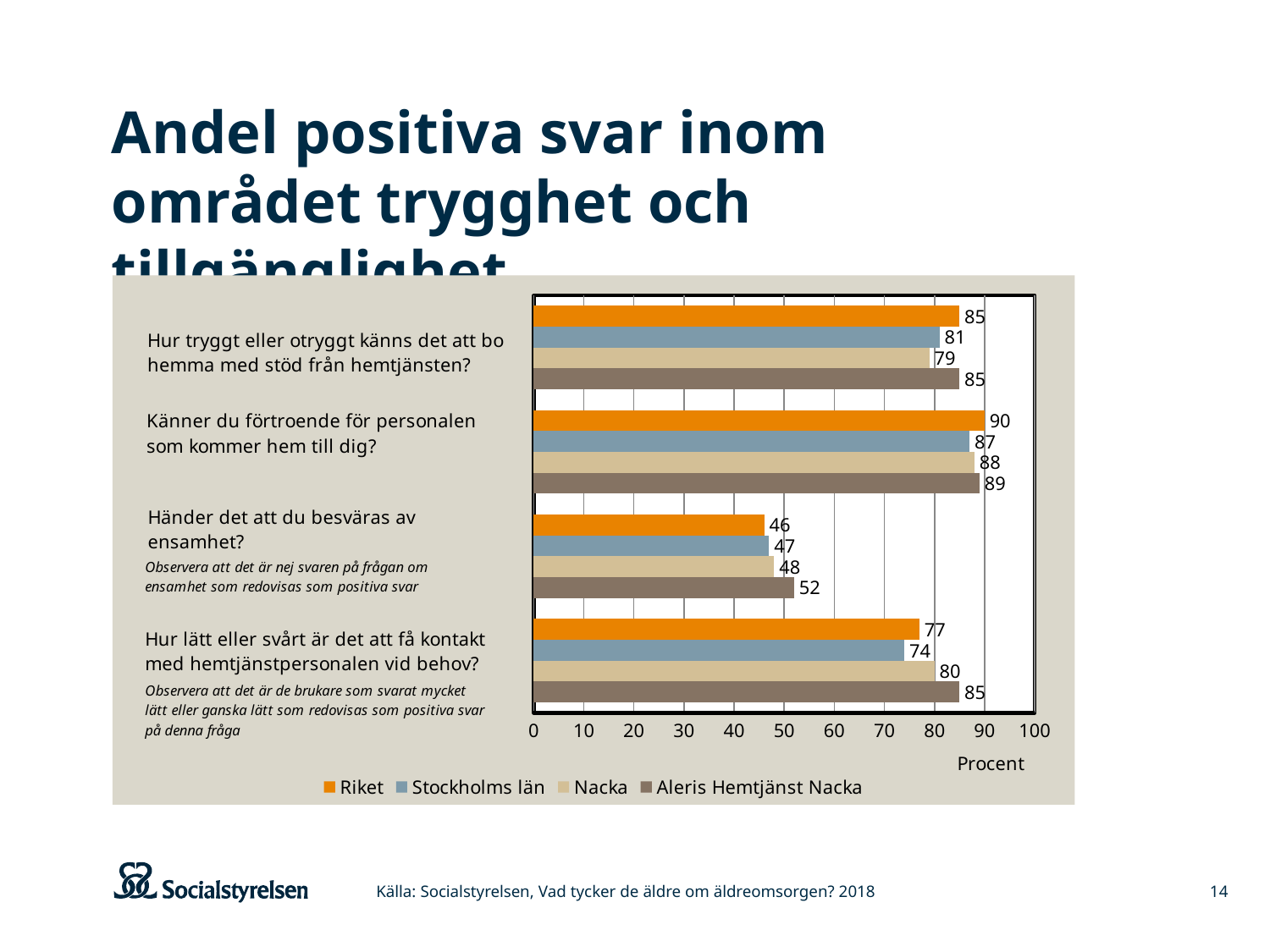
Which is larger on the question 'Hur tryggt eller otryggt känns det att bo hemma med stöd från hemtjänsten?': Stockholms län or Nacka? Stockholms län Which series has the lowest value on the question 'Händer det att du besväras av ensamhet?' Riket What is the difference between Aleris Hemtjänst Nacka and Stockholms län on the question 'Hur lätt eller svårt är det att få kontakt med hemtjänstpersonalen vid behov?' 11 What is the value for Riket on the question 'Känner du förtroende för personalen som kommer hem till dig?' 90 What is the value for Aleris Hemtjänst Nacka on the question 'Händer det att du besväras av ensamhet?' 52 What is the value for Nacka on the question 'Hur tryggt eller otryggt känns det att bo hemma med stöd från hemtjänsten?' 79 What kind of chart is shown on the slide? Bar chart What is the value for Stockholms län on the question 'Hur lätt eller svårt är det att få kontakt med hemtjänstpersonalen vid behov?' 74 How many series does the legend list? 4 What label is shown on the horizontal axis of the chart? Procent Which series has the highest value on the question 'Hur lätt eller svårt är det att få kontakt med hemtjänstpersonalen vid behov?' Aleris Hemtjänst Nacka How many question categories are plotted on the chart? 4